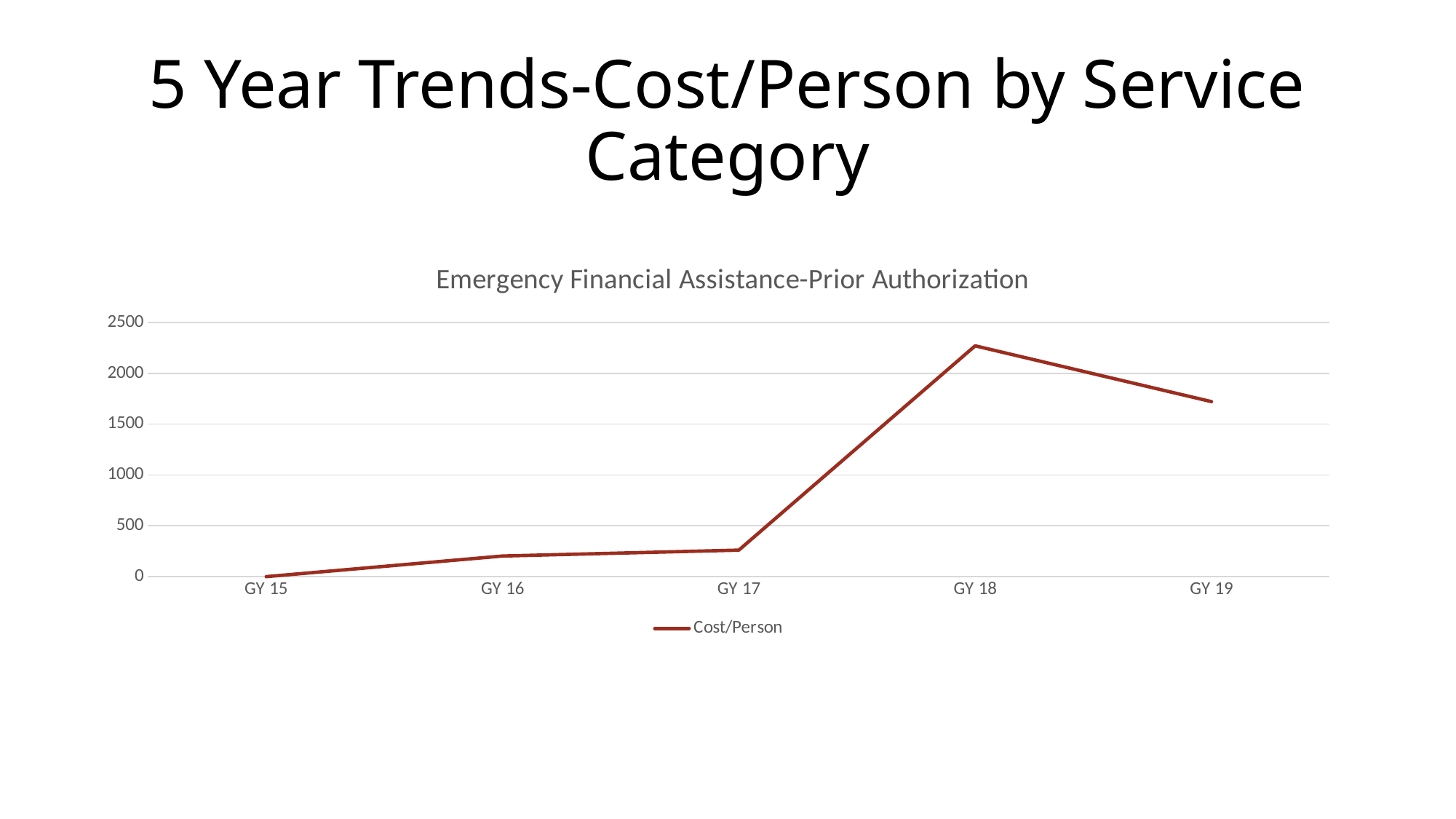
What kind of chart is shown on the slide? line chart How many grant years are plotted on the x axis? 5 What is the title of the chart? Emergency Financial Assistance-Prior Authorization Does the Cost/Person rise or fall from GY 18 to GY 19? fall Is the Cost/Person for GY 18 greater or less than 2000? greater How many series does the legend list? 1 Which has a higher Cost/Person, GY 18 or GY 19? GY 18 Is the Cost/Person for GY 19 greater or less than 1500? greater What is the name of the series shown in the legend? Cost/Person Is the Cost/Person for GY 17 greater or less than 500? less Which grant year has the lowest Cost/Person? GY 15 Which grant year has the highest Cost/Person? GY 18